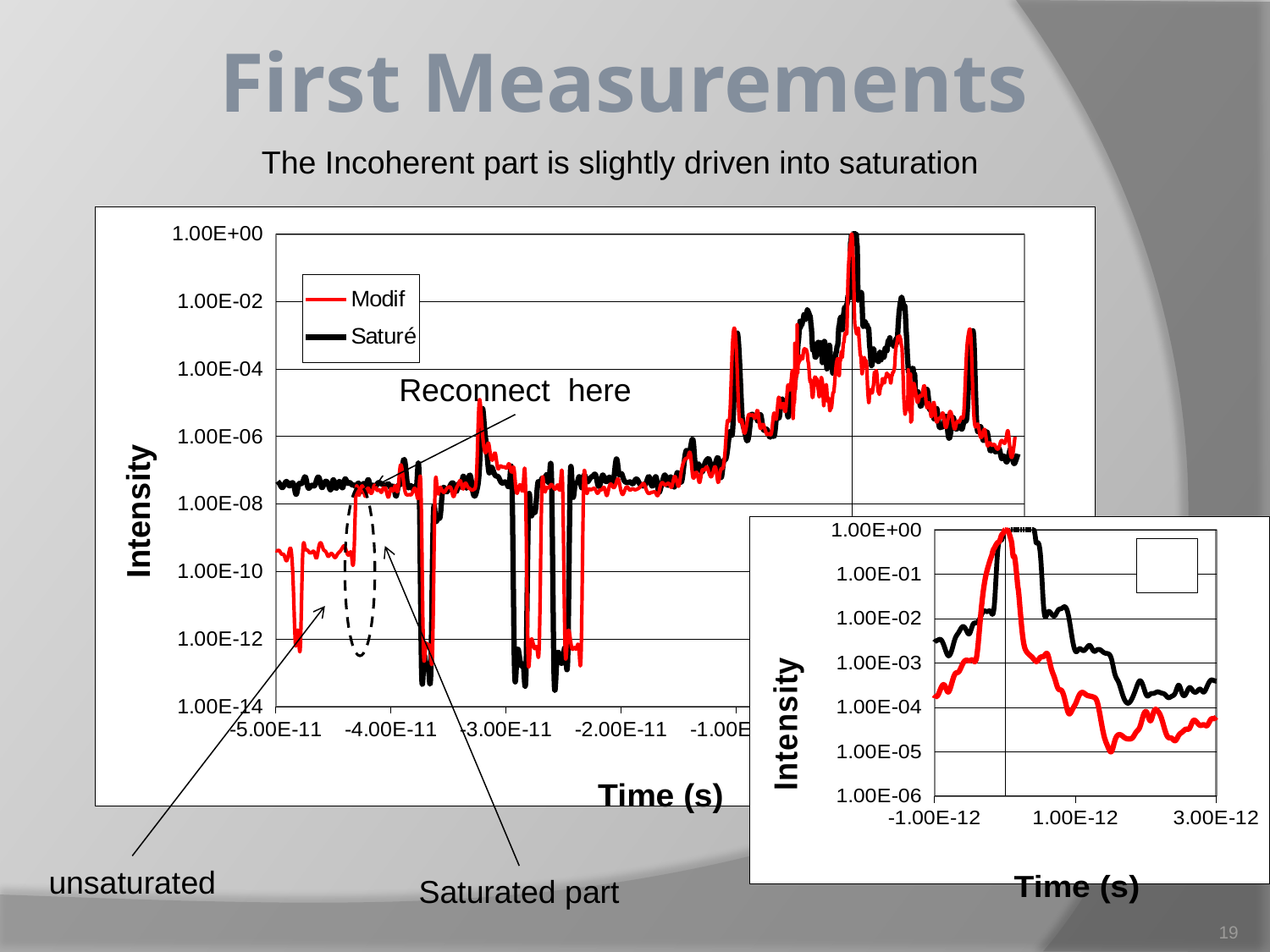
In the inset chart at the bottom right, is the red line's value at 3.00E-12 greater or less than 1.00E-04? less What are the two series named in the legend of the large chart? Modif and Saturé How many series does the legend of the large chart list? 2 In the large chart, is the Saturé value at the far left (around -5.00E-11) greater or less than 1.00E-08? greater In the large chart, is the Modif value at the far left (around -5.00E-11) greater or less than 1.00E-08? less In the inset chart at the bottom right, which line is higher at 3.00E-12, the red line or the black line? the black line What kind of chart is the large chart on the slide? line chart In the large chart, at the far left of the x-axis (around -5.00E-11), which series has the higher intensity, Modif or Saturé? Saturé What is the label on the y-axis of the large chart? Intensity What kind of chart is the inset chart at the bottom right of the slide? line chart